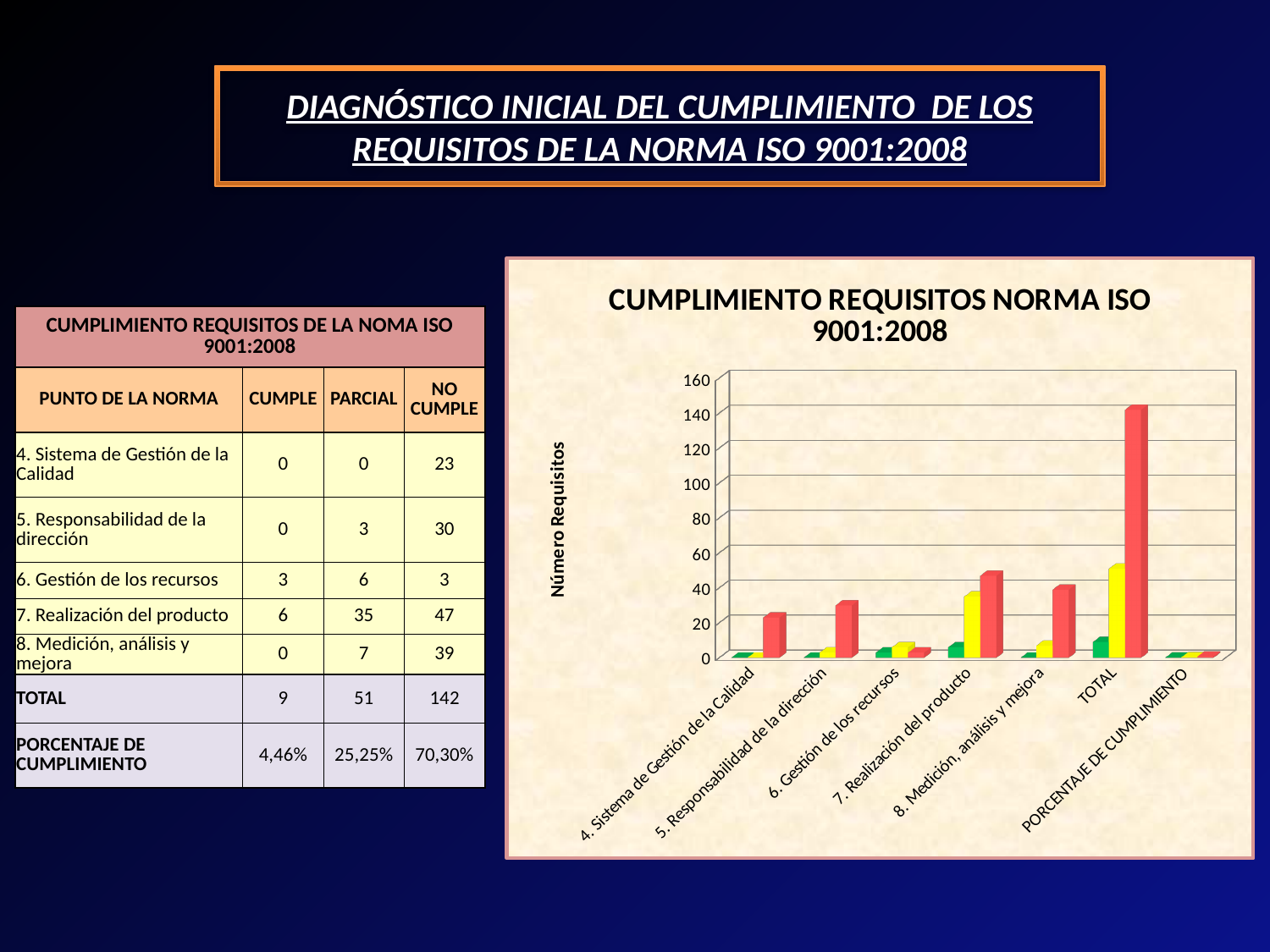
What is the label of the vertical axis of the chart? Número Requisitos Is the yellow bar for TOTAL greater or less than 40? greater Is the yellow bar for 7. Realización del producto greater or less than 40? less Which is taller in the chart: the red bar for 7. Realización del producto or the red bar for 4. Sistema de Gestión de la Calidad? 7. Realización del producto Is the tallest red bar (TOTAL) greater or less than 120? greater How many categories are shown along the x axis of the chart? 7 Which category has the tallest bar in the chart? TOTAL What is the title of the chart? CUMPLIMIENTO REQUISITOS NORMA ISO 9001:2008 What is the highest value shown on the vertical axis of the chart? 160 What kind of chart is shown on the slide? bar chart